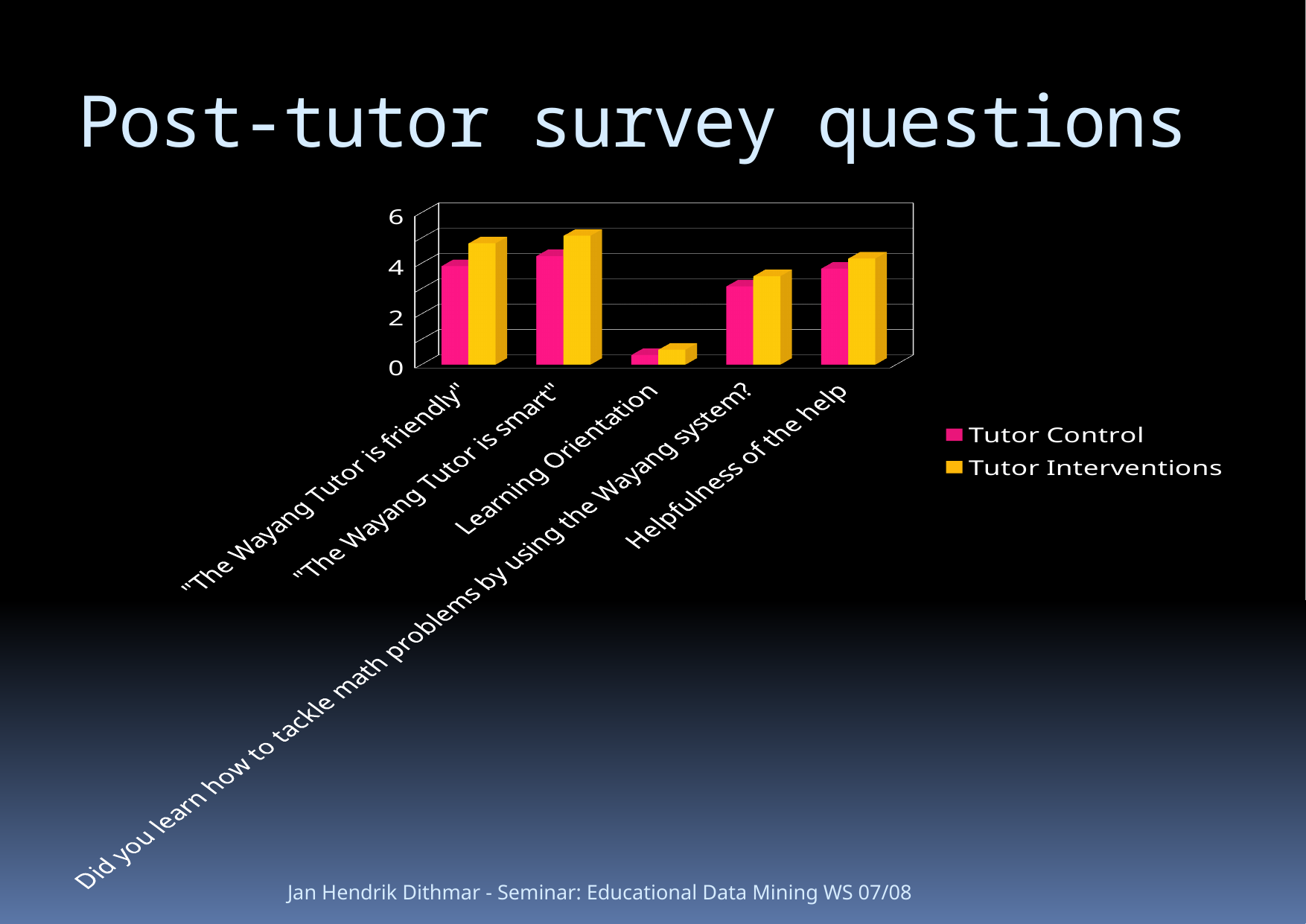
Is the Tutor Interventions value for "The Wayang Tutor is smart" greater or less than 4? greater Is the Tutor Control value for "Did you learn how to tackle math problems by using the Wayang system?" greater or less than 2? greater Which series is shown in yellow in the legend? Tutor Interventions What kind of chart is shown on the slide? bar chart Which category has the lowest value for Tutor Control? Learning Orientation How many series does the legend list? 2 For Tutor Interventions, which is larger: Learning Orientation or Helpfulness of the help? Helpfulness of the help What is the title of the slide containing the chart? Post-tutor survey questions Which category has the lowest value for Tutor Interventions? Learning Orientation How many survey question categories are plotted on the x axis? 5 For "The Wayang Tutor is friendly", which series has the larger value, Tutor Control or Tutor Interventions? Tutor Interventions Is the Tutor Control value for Learning Orientation greater or less than 2? less